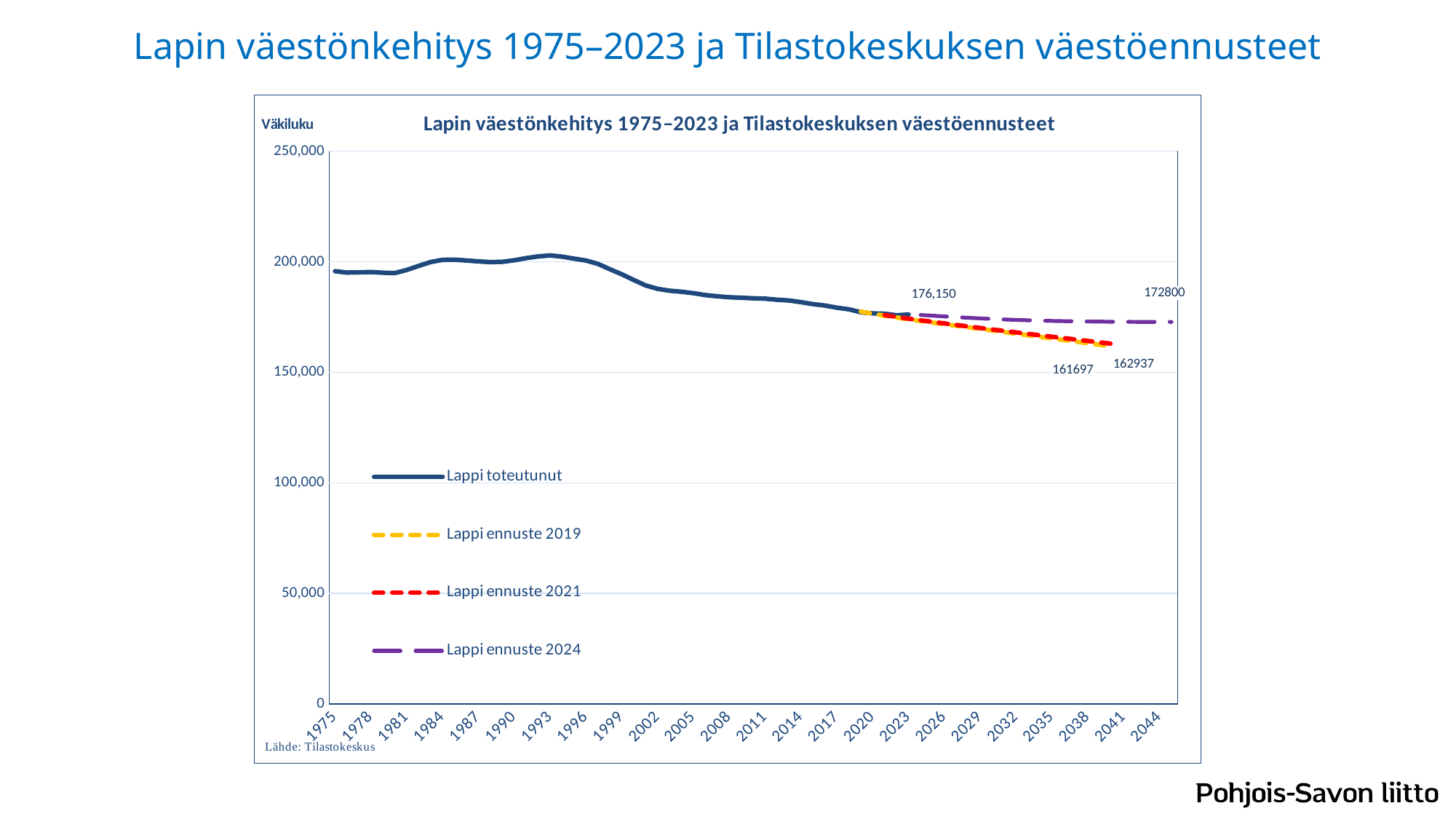
What is the difference between the labelled value 176,150 and the labelled end value of the Lappi ennuste 2024 line, 172800? 3,350 What source is cited below the chart? Tilastokeskus Is the Lappi toteutunut value in 2002 greater or less than 200,000? less What is the label on the vertical axis of the chart? Väkiluku Which forecast series ends at the highest value? Lappi ennuste 2024 Does the Lappi toteutunut line rise or fall between 1996 and 2023? fall What value is labelled at the end of the Lappi toteutunut line, around 2023? 176,150 How many series does the legend list? 4 Is the Lappi toteutunut value in 1993 greater or less than 200,000? greater What kind of chart is shown on the slide? line chart Is the Lappi toteutunut value in 2017 greater or less than 150,000? greater What value is labelled at the end of the Lappi ennuste 2024 line? 172800